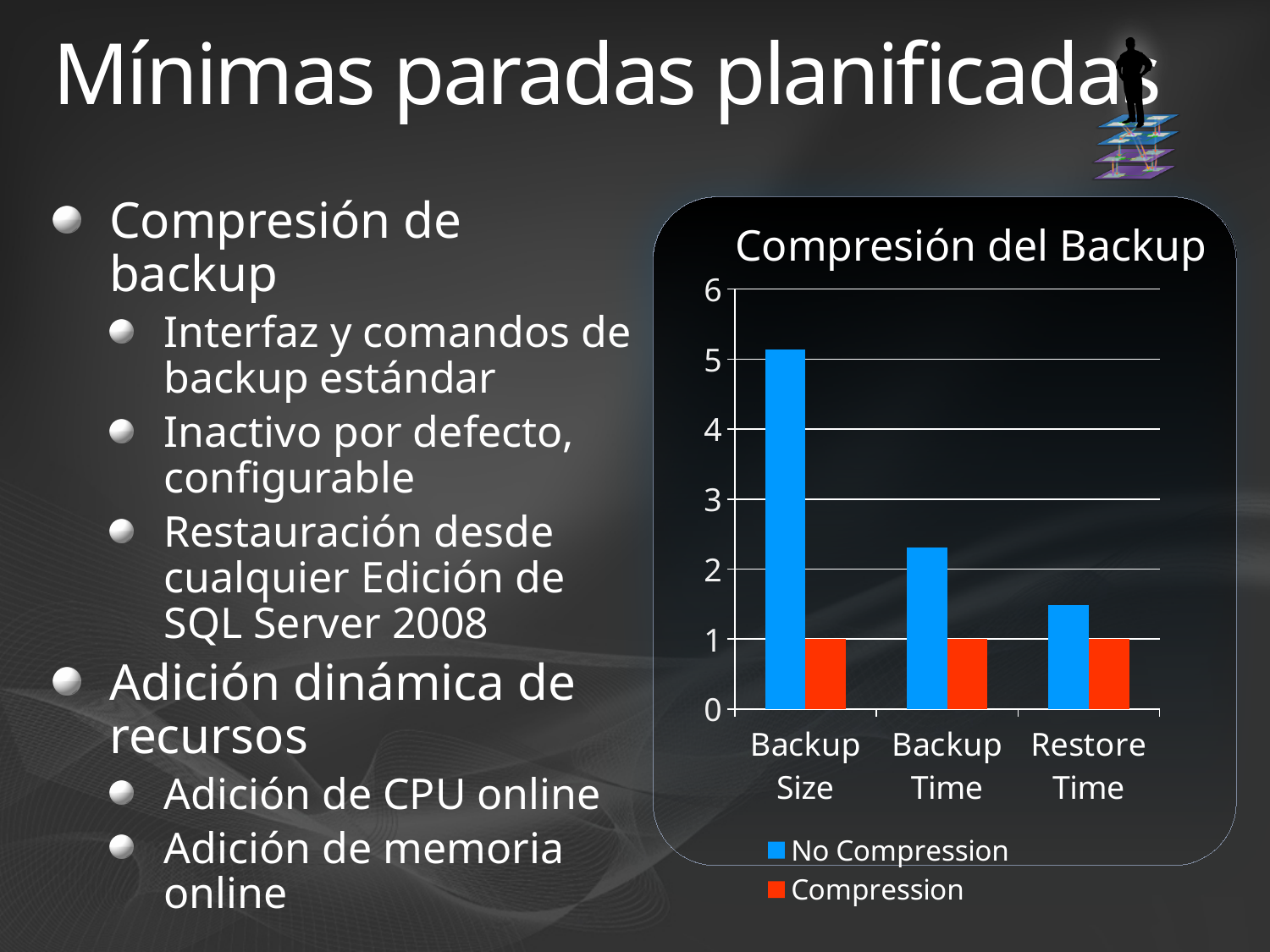
Which series is shown in blue in the chart? No Compression In the Backup Time category, which is larger: No Compression or Compression? No Compression Which category has the highest No Compression value? Backup Size What is the value for Compression in the Restore Time category? 1 What is the title of the chart? Compresión del Backup Which category has the lowest No Compression value? Restore Time What is the value for Compression in the Backup Size category? 1 Is the No Compression value for Restore Time greater or less than 2? less How many series does the chart legend list? 2 What type of chart is shown on the slide? bar chart Is the No Compression value for Backup Size greater or less than 4? greater How many categories are shown on the x axis of the chart? 3